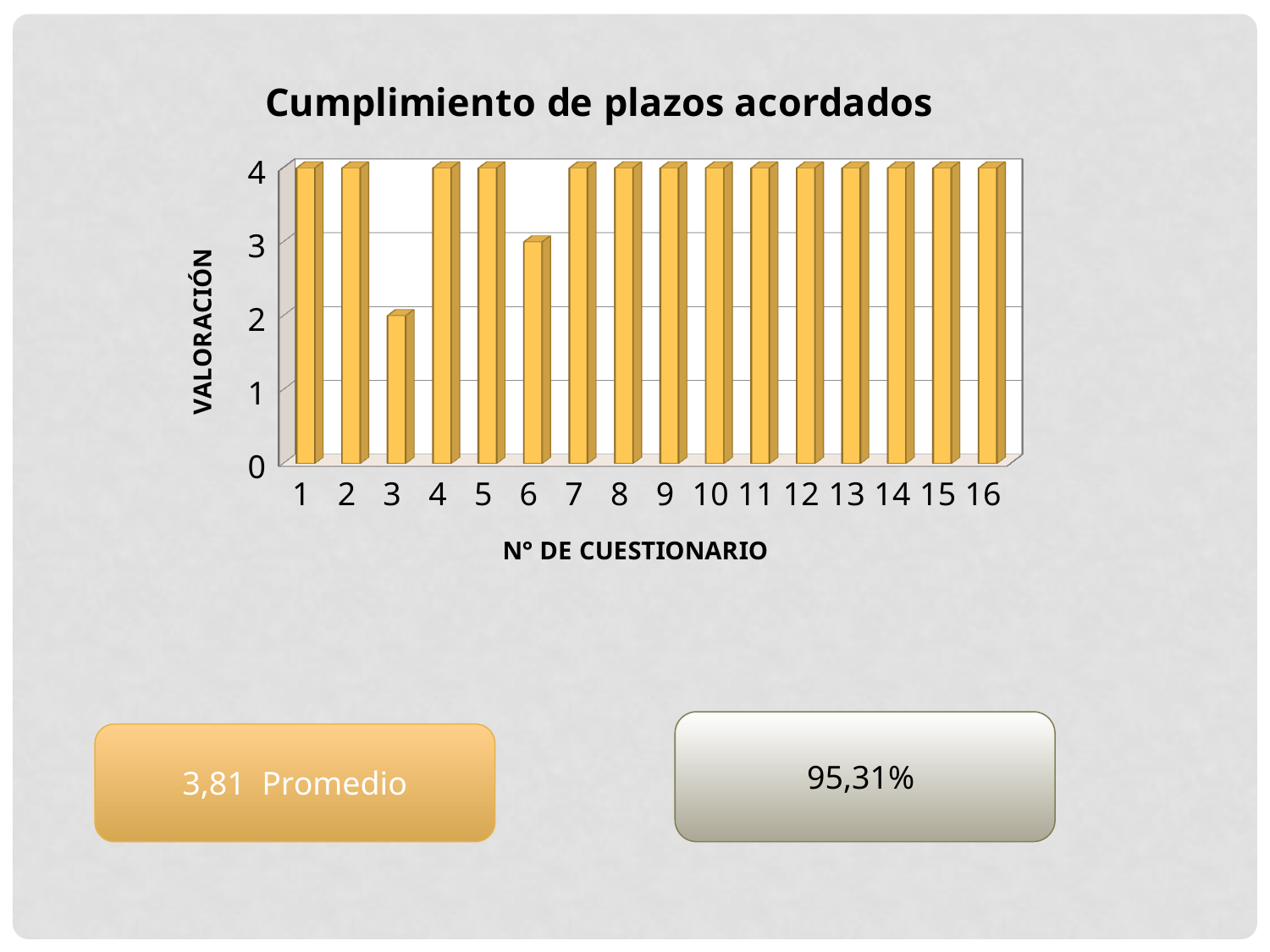
Which questionnaire number has the lowest valoración? 3 What is the difference between the valoración for questionnaire 6 and questionnaire 3? 1 What is the label of the y axis? VALORACIÓN What type of chart is shown on the slide? bar chart How many questionnaires have a valoración of 4? 14 Which has a higher valoración, questionnaire 3 or questionnaire 6? questionnaire 6 How many questionnaires (categories) are plotted on the x axis? 16 What is the valoración for questionnaire number 6? 3 What is the title of the chart? Cumplimiento de plazos acordados What is the valoración for questionnaire number 1? 4 Is the value for questionnaire 3 greater or less than 3? less What is the valoración for questionnaire number 3? 2